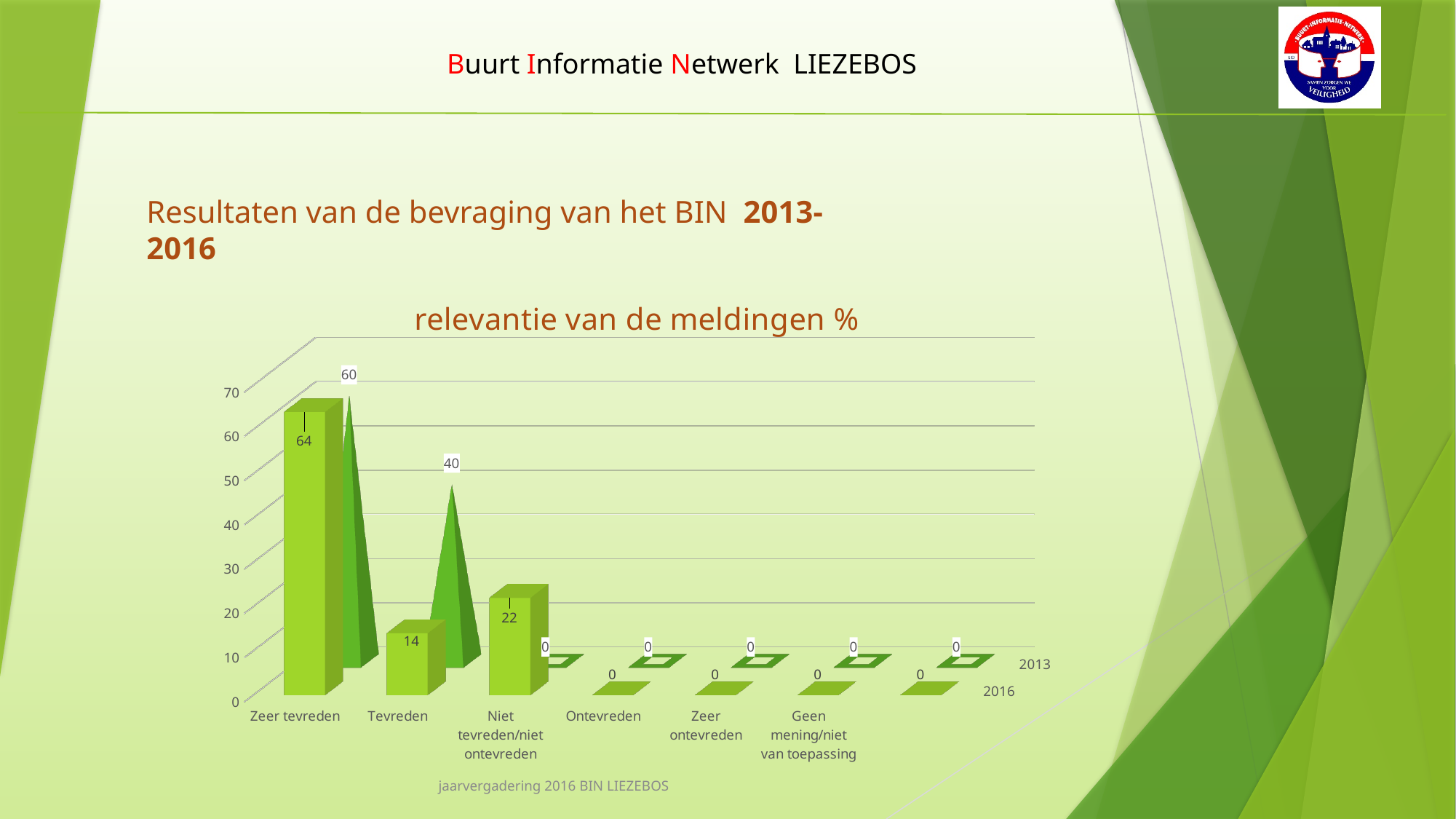
For Tevreden, which series has the larger value, 2013 or 2016? 2013 What is the difference between the 2016 and 2013 values for Zeer tevreden? 4 What is the value for Zeer tevreden in the 2013 series? 60 What is the difference between the 2013 and 2016 values for Tevreden? 26 What is the value for Ontevreden in the 2016 series? 0 What is the value for Niet tevreden/niet ontevreden in the 2016 series? 22 How many data series does the chart show? 2 What is the value for Zeer tevreden in the 2016 series? 64 What is the difference between the 2016 values for Zeer tevreden and Tevreden? 50 What is the value for Tevreden in the 2013 series? 40 What kind of chart is shown on the slide? bar chart Which category has the highest value in the 2016 series? Zeer tevreden